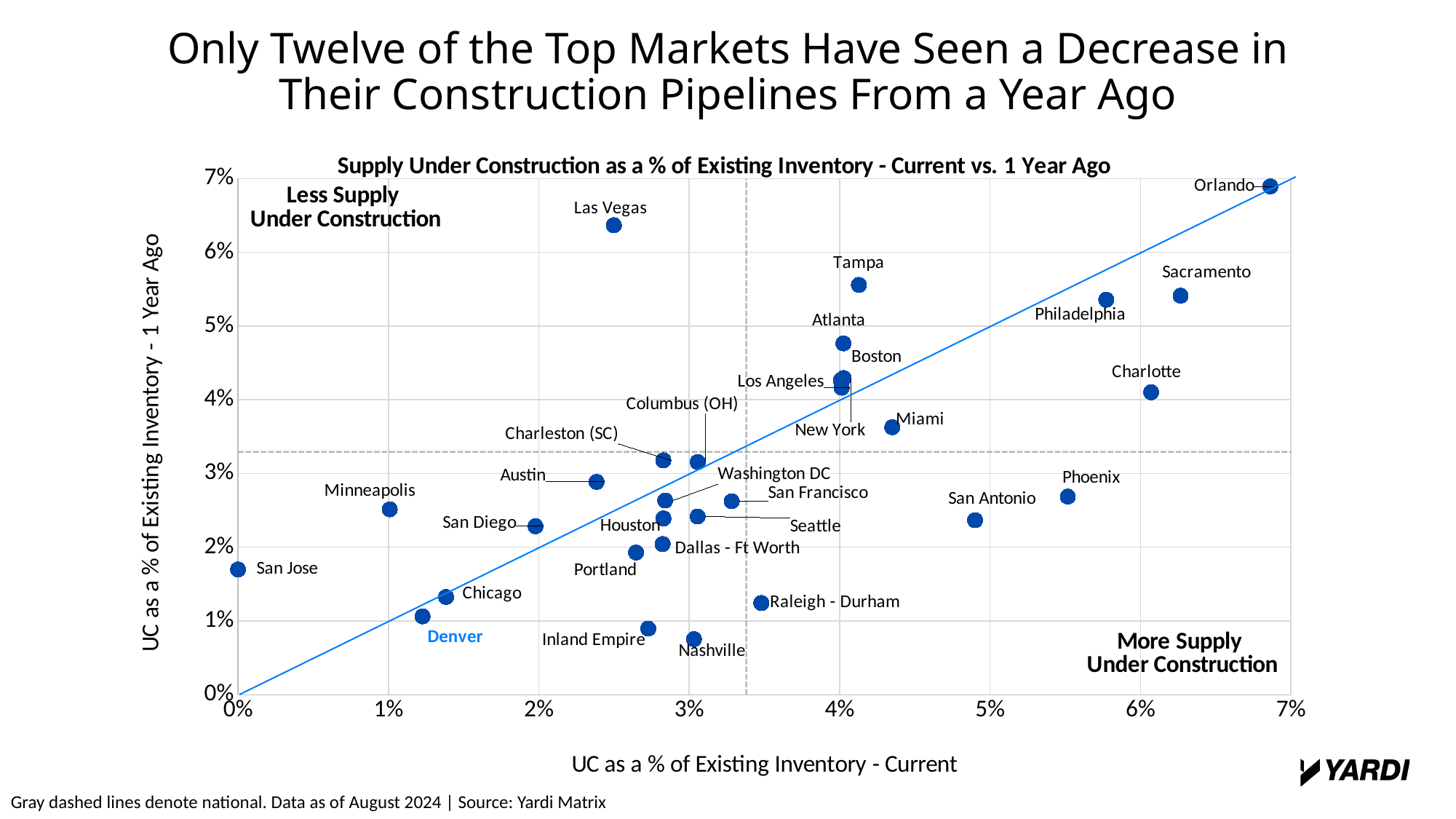
Is the current value for Phoenix greater or less than 5%? greater Which market had a higher UC as a % of existing inventory 1 year ago, Las Vegas or Sacramento? Las Vegas Is the 1-year-ago value for Raleigh - Durham greater or less than 2%? less Which market has the highest current UC as a % of existing inventory? Orlando Which market has the lowest current UC as a % of existing inventory? San Jose What kind of chart is shown on the slide? Scatter chart Is the 1-year-ago value for Las Vegas greater or less than 6%? greater Which market has the lowest UC as a % of existing inventory 1 year ago? Nashville Which market label is highlighted in blue on the chart? Denver Which market has a higher current UC as a % of existing inventory, Phoenix or San Antonio? Phoenix